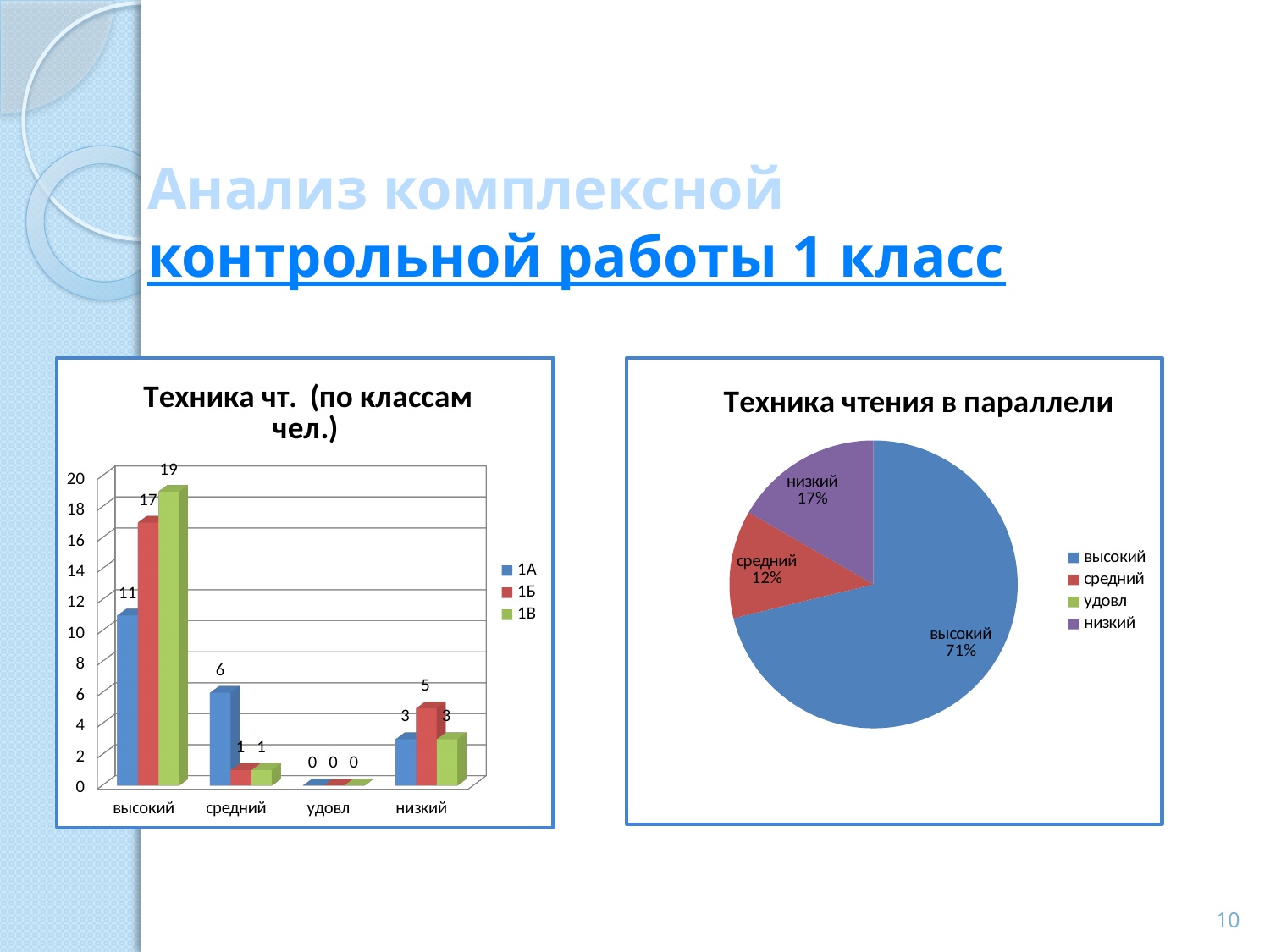
In the bar chart "Техника чт. (по классам чел.)", what is the difference between the 1Б and 1А values in the высокий category? 6 In the pie chart "Техника чтения в параллели", what share does the высокий slice have? 71% In the pie chart "Техника чтения в параллели", what share does the средний slice have? 12% In the bar chart "Техника чт. (по классам чел.)", what is the value for 1А in the средний category? 6 In the pie chart "Техника чтения в параллели", how many entries does the legend list? 4 In the bar chart "Техника чт. (по классам чел.)", how many series does the legend list? 3 In the bar chart "Техника чт. (по классам чел.)", what is the value for 1В in the высокий category? 19 What kind of chart is the left chart titled "Техника чт. (по классам чел.)"? bar chart In the bar chart "Техника чт. (по классам чел.)", what is the value for 1Б in the низкий category? 5 In the bar chart "Техника чт. (по классам чел.)", how many categories are shown on the x axis? 4 In the bar chart "Техника чт. (по классам чел.)", which is larger: the 1А value for средний or the 1А value for низкий? средний In the bar chart "Техника чт. (по классам чел.)", which series has the highest value in the высокий category? 1В